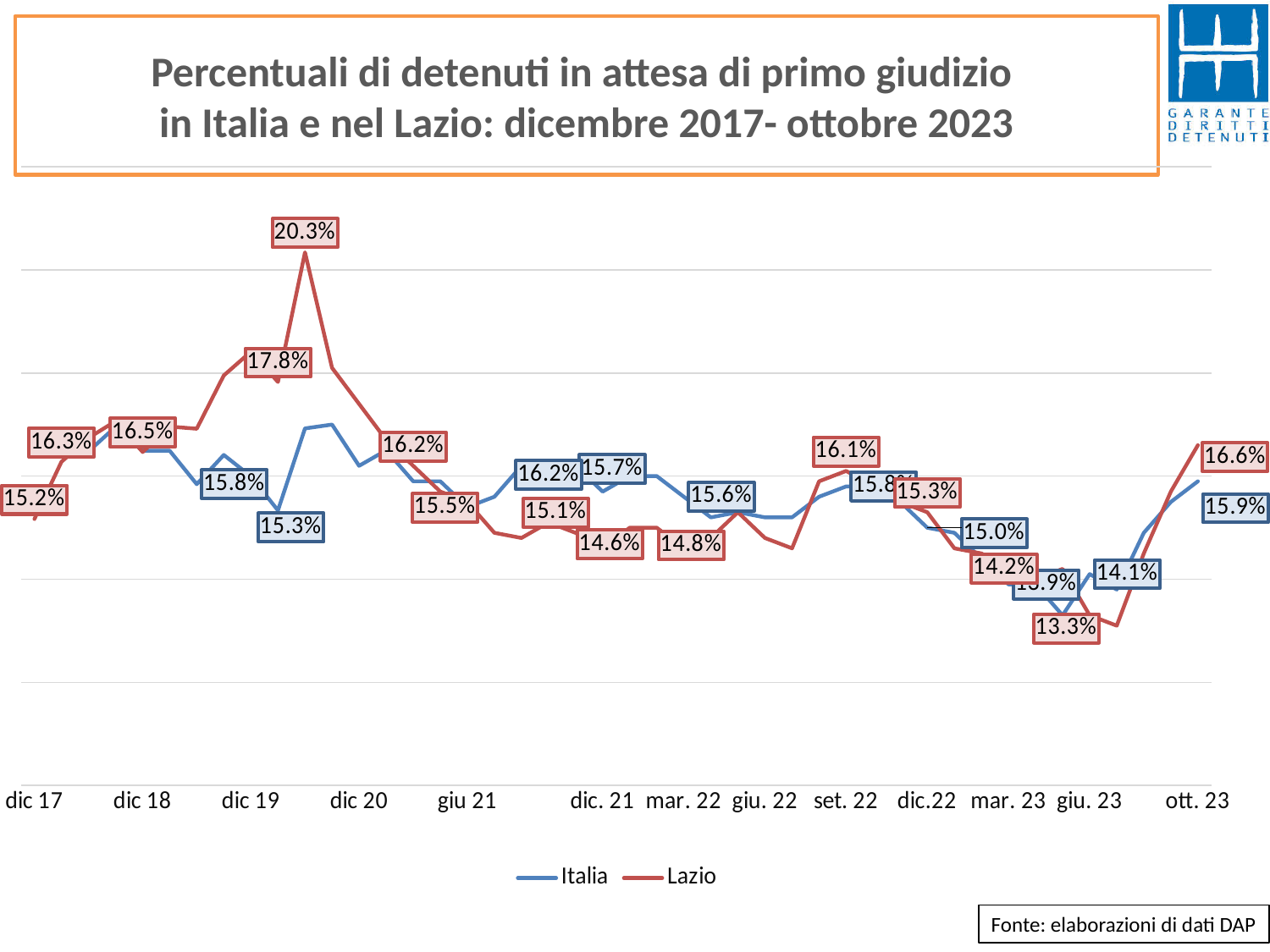
What is the difference between the Lazio and Italia values at ott. 23? 0.7 percentage points At ott. 23, which series has the higher value, Italia or Lazio? Lazio What kind of chart is shown on the slide? line chart Does the Lazio series rise or fall between giu. 23 and ott. 23? rise What is the highest value reached by the Lazio series? 20.3% What is the value for Italia at ott. 23? 15.9% What is the value for Lazio at dic 17? 15.2% What is the value for Lazio at ott. 23? 16.6% How many series does the legend list? 2 Which two series are listed in the legend? Italia and Lazio